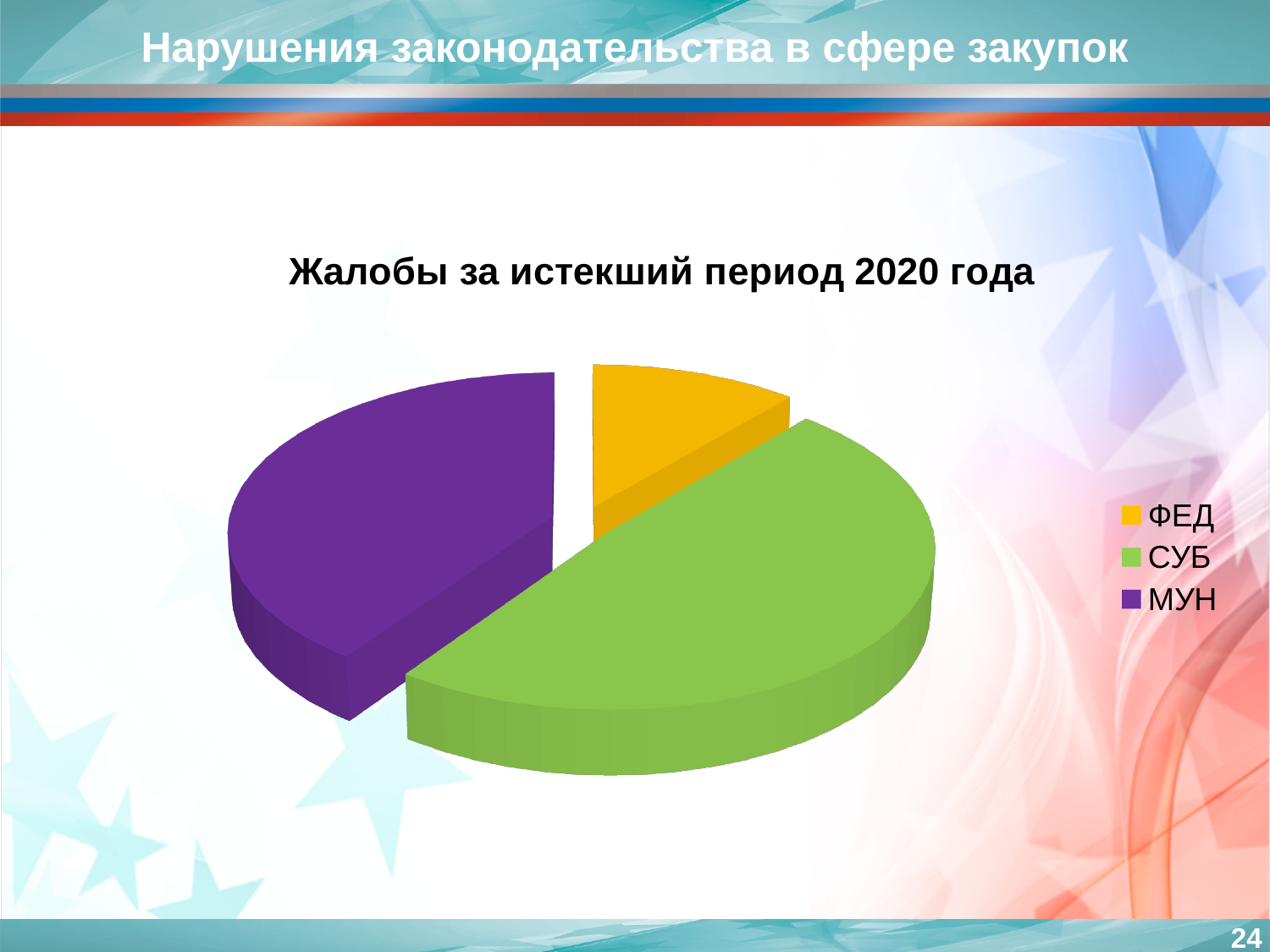
How many slices does the pie chart have? 3 Which category has the smallest slice of the pie chart? ФЕД Which slice is larger, МУН or ФЕД? МУН Which slice is larger, СУБ or МУН? СУБ What kind of chart is shown on the slide? pie chart What is the title of the pie chart? Жалобы за истекший период 2020 года How many entries does the legend of the pie chart list? 3 Which slice is larger, СУБ or ФЕД? СУБ What colour is the МУН slice in the pie chart? purple Which category has the largest slice of the pie chart? СУБ